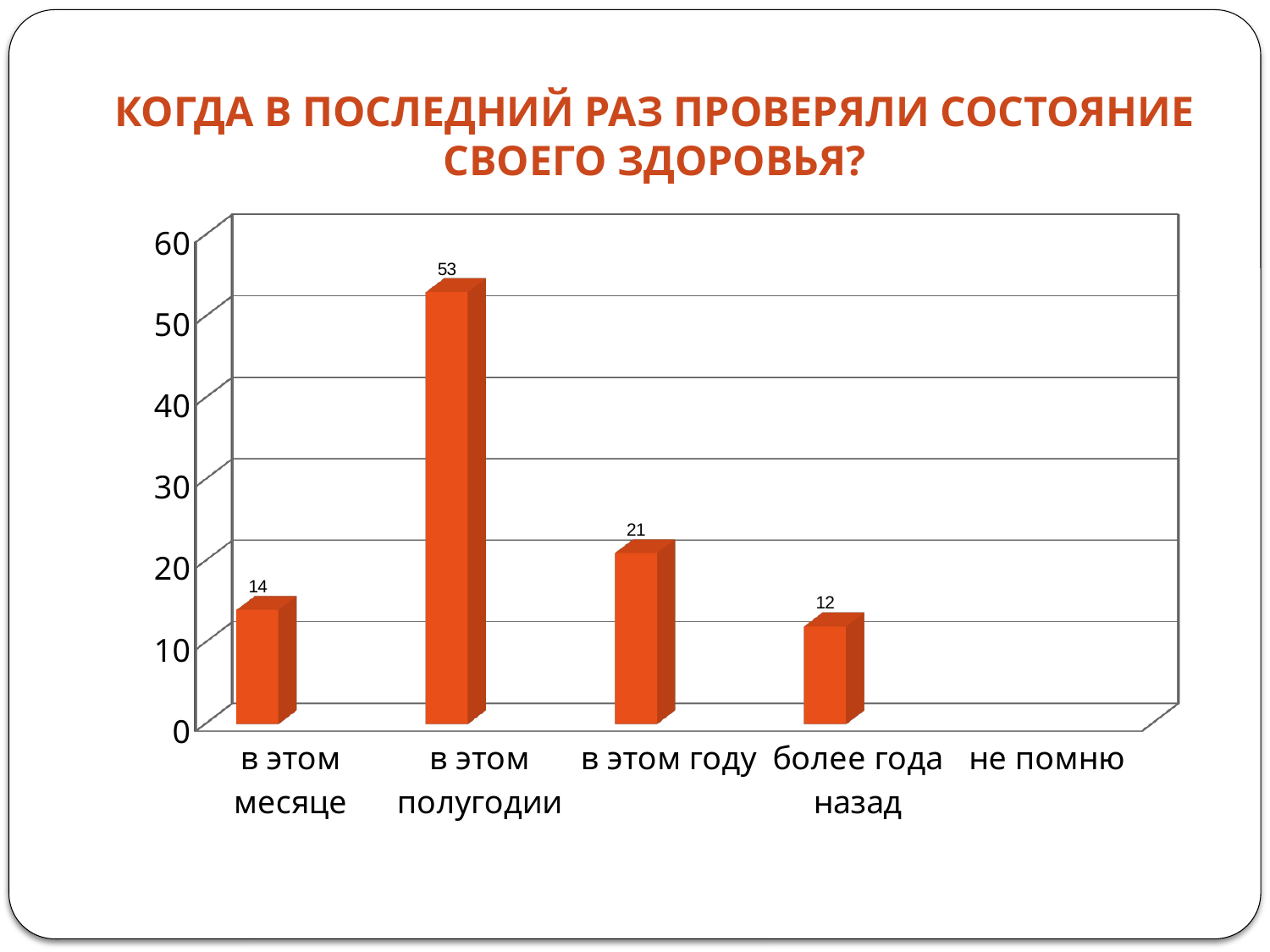
What kind of chart is shown on the slide? bar chart Which is larger, the value for "в этом году" or the value for "в этом месяце"? в этом году What is the difference between the values for "в этом году" and "более года назад"? 9 What is the value for "более года назад"? 12 What is the difference between the values for "в этом полугодии" and "в этом месяце"? 39 What is the value for "в этом полугодии"? 53 Is the value for "в этом полугодии" greater or less than 50? greater How many categories are labelled on the horizontal axis? 5 Among the bars shown, which category has the lowest value? более года назад What is the value for "в этом месяце"? 14 Which category has the highest value? в этом полугодии What is the value for "в этом году"? 21